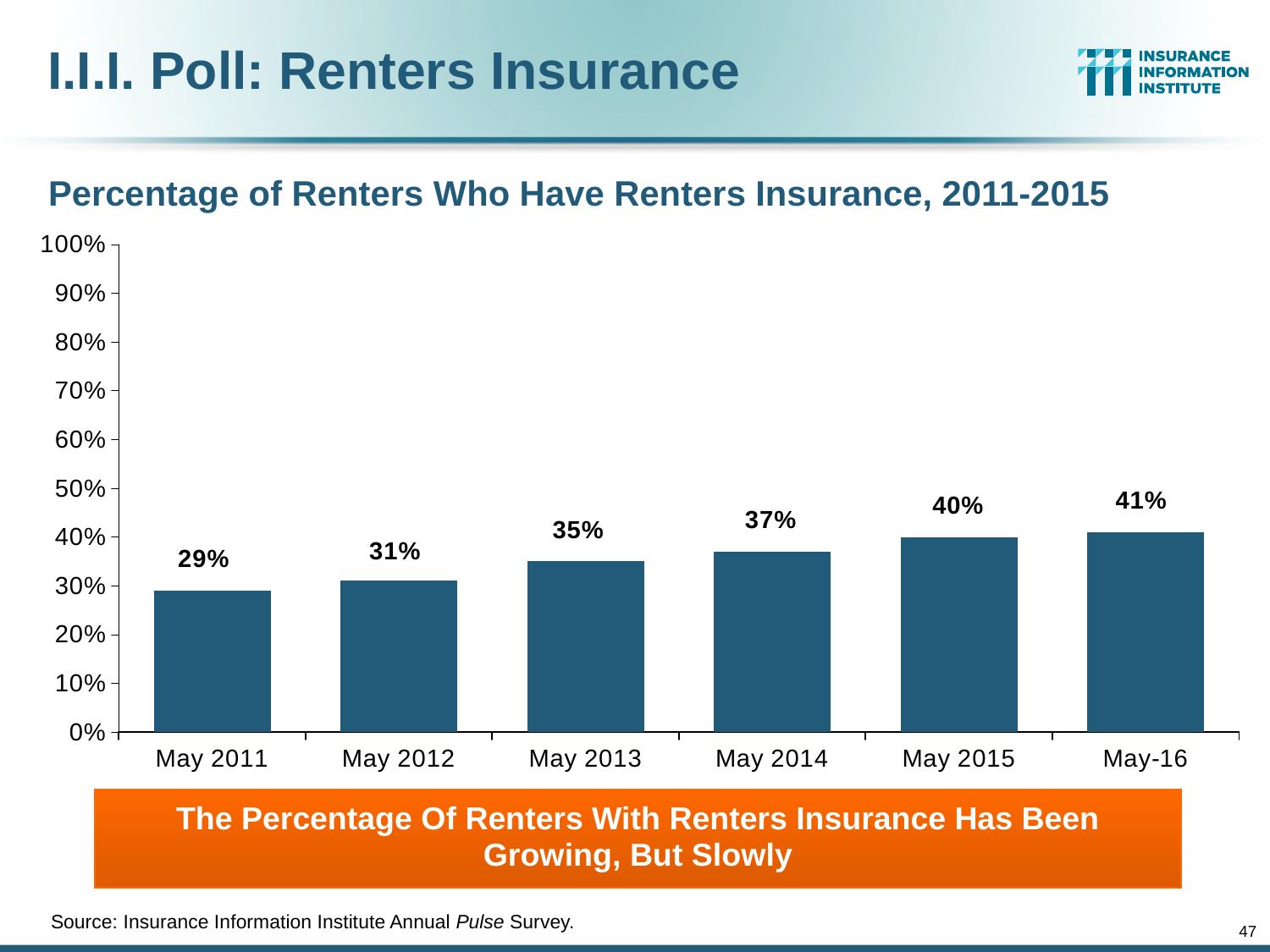
What is the value shown for May-16? 41% Do the values rise or fall from May 2011 to May-16? Rise What percentage of renters had renters insurance in May 2011? 29% What kind of chart is shown on the slide? Bar chart How many time periods are shown on the x axis? 6 Is the value for May 2012 greater or less than 40%? less What is the value shown for May 2014? 37% Which period has the lowest percentage of renters with renters insurance? May 2011 Which period has the highest percentage of renters with renters insurance? May-16 By how many percentage points did the value increase from May 2011 to May-16? 12 percentage points Which is larger, the value for May 2015 or the value for May 2013? May 2015 What is the difference between the values for May 2013 and May 2012? 4 percentage points